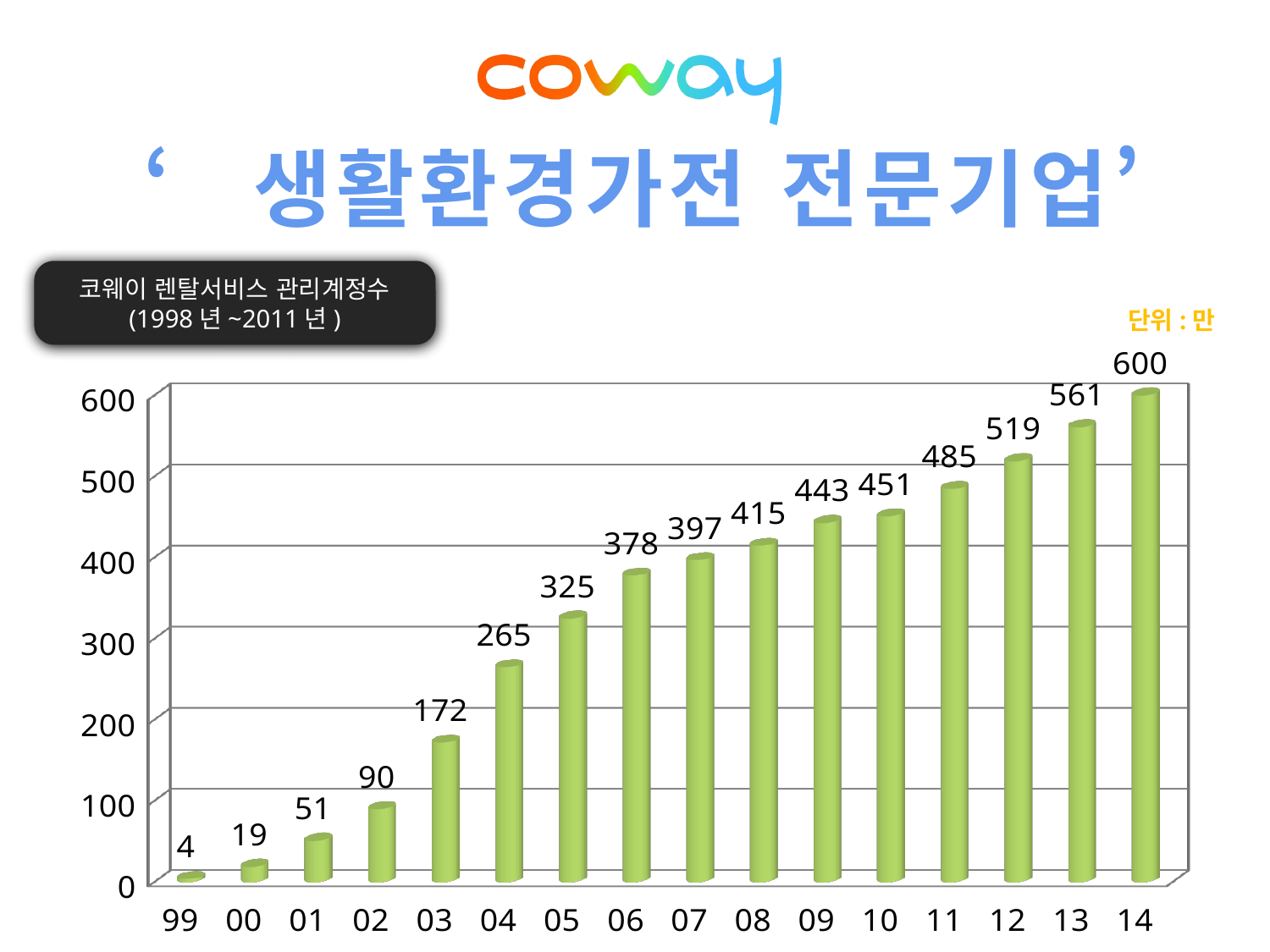
What kind of chart is shown on the slide? bar chart Which year has the highest value? 14 What unit is stated for the chart values? 만 What is the difference between the values for 14 and 13? 39 What is the value for 10? 451 What is the value for 99? 4 Which is larger, the value for 07 or the value for 11? 11 What is the difference between the values for 05 and 04? 60 What is the value for 03? 172 Which year has the lowest value? 99 How many bars are shown in the chart? 16 Do the values rise or fall from 99 to 14? rise